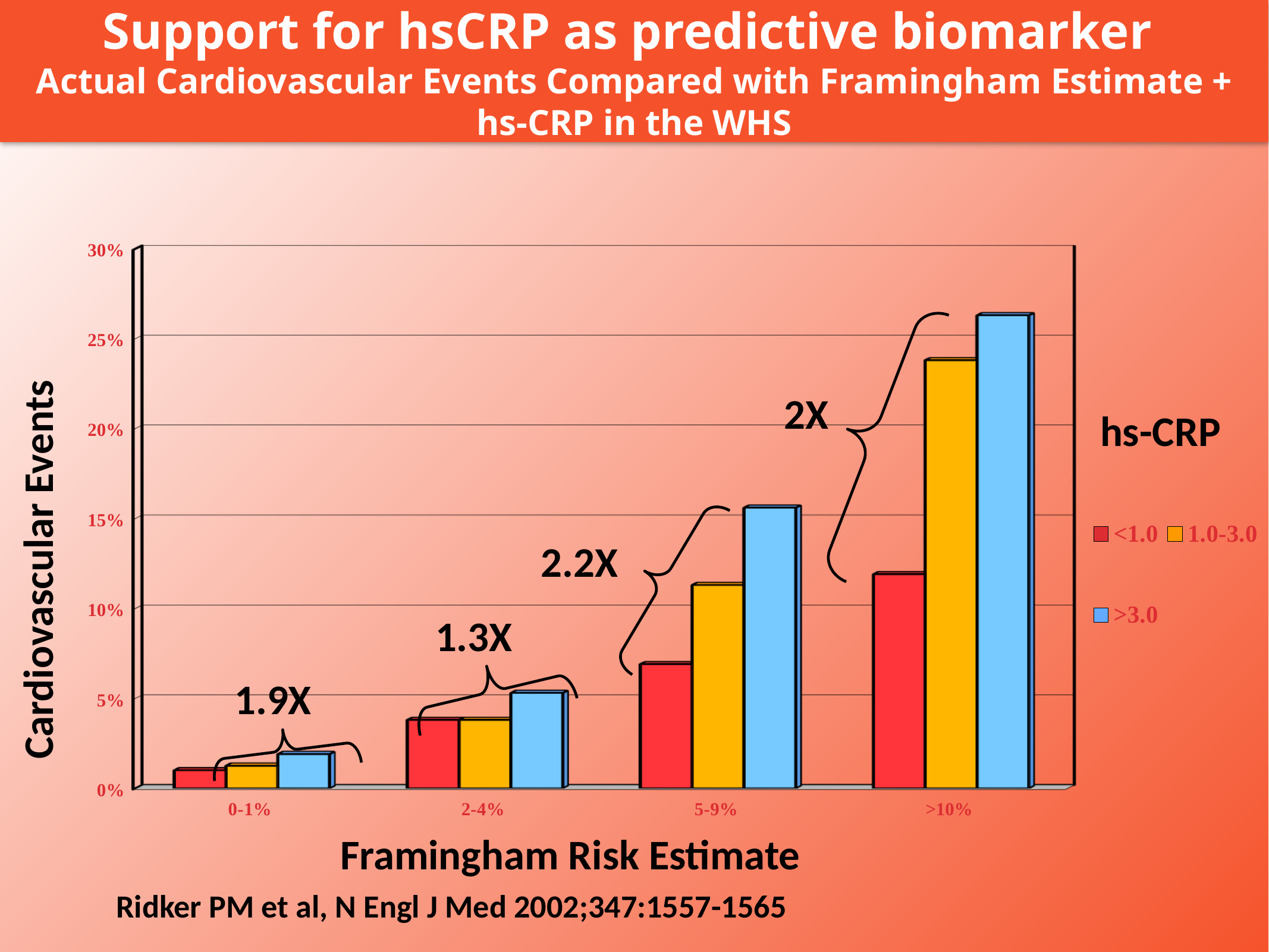
How many hs-CRP series does the legend list? 3 What multiplier annotation is shown above the 5-9% Framingham Risk Estimate group? 2.2X Is the value for the 1.0-3.0 hs-CRP series in the >10% category greater or less than 20%? greater Is the value for the <1.0 hs-CRP series in the >10% category greater or less than 15%? less What kind of chart is shown on the slide? bar chart Is the value for the >3.0 hs-CRP series in the >10% category greater or less than 25%? greater Which Framingham Risk Estimate category has the lowest bar for the <1.0 hs-CRP series? 0-1% Which Framingham Risk Estimate category has the highest bar for the >3.0 hs-CRP series? >10% In the 5-9% category, which hs-CRP series has the larger value, <1.0 or >3.0? >3.0 Do the cardiovascular event values for the >3.0 hs-CRP series rise or fall as the Framingham Risk Estimate increases along the x axis? rise How many Framingham Risk Estimate categories are shown on the x axis? 4